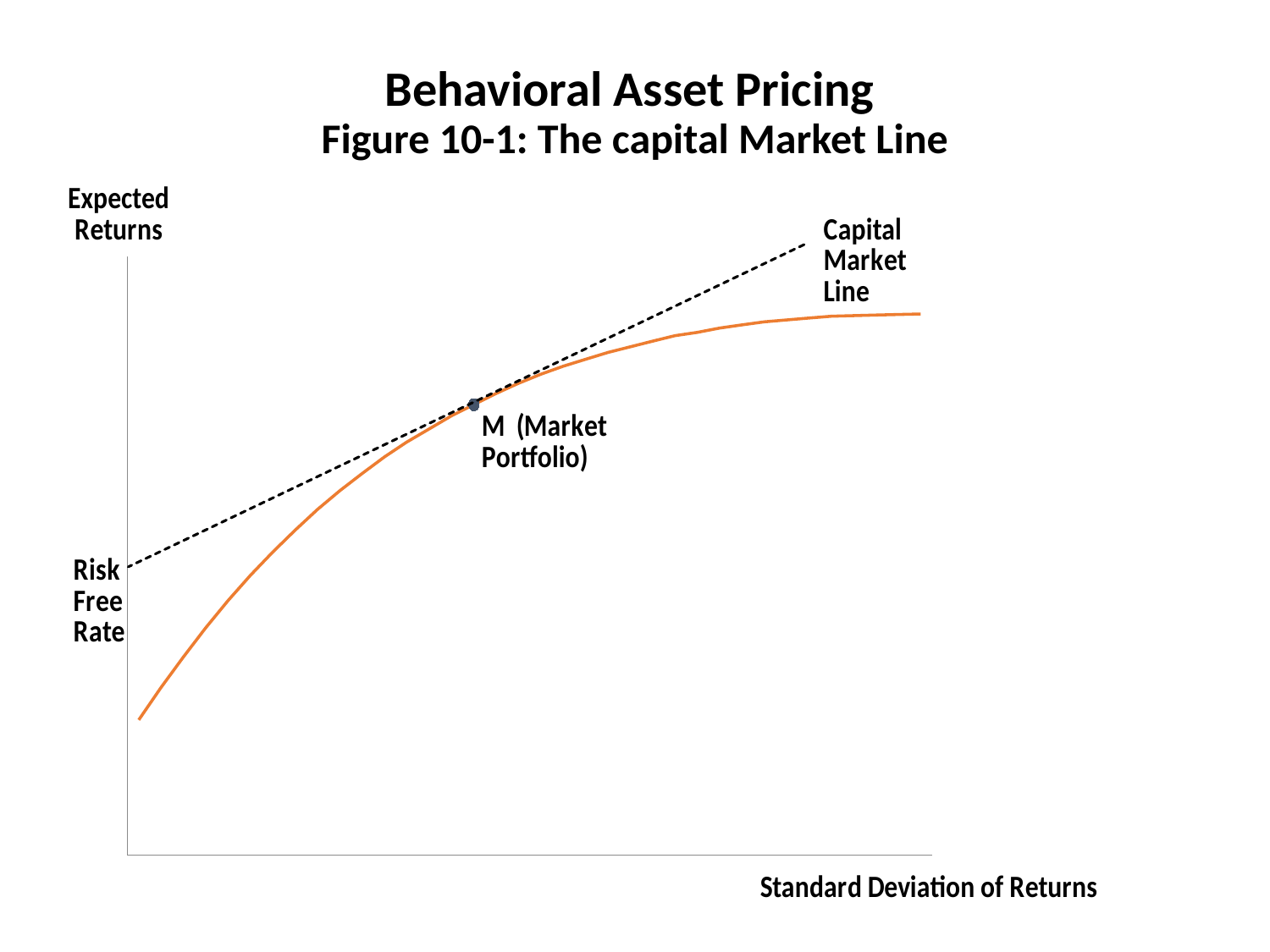
At the far right of the chart, which is higher: the dashed Capital Market Line or the orange curve? The dashed Capital Market Line Does the orange curve rise or fall as you move to the right along the x axis? Rises What is the label on the vertical axis of the chart? Expected Returns What is the label on the horizontal axis of the chart? Standard Deviation of Returns What kind of chart is shown on the slide? Line chart